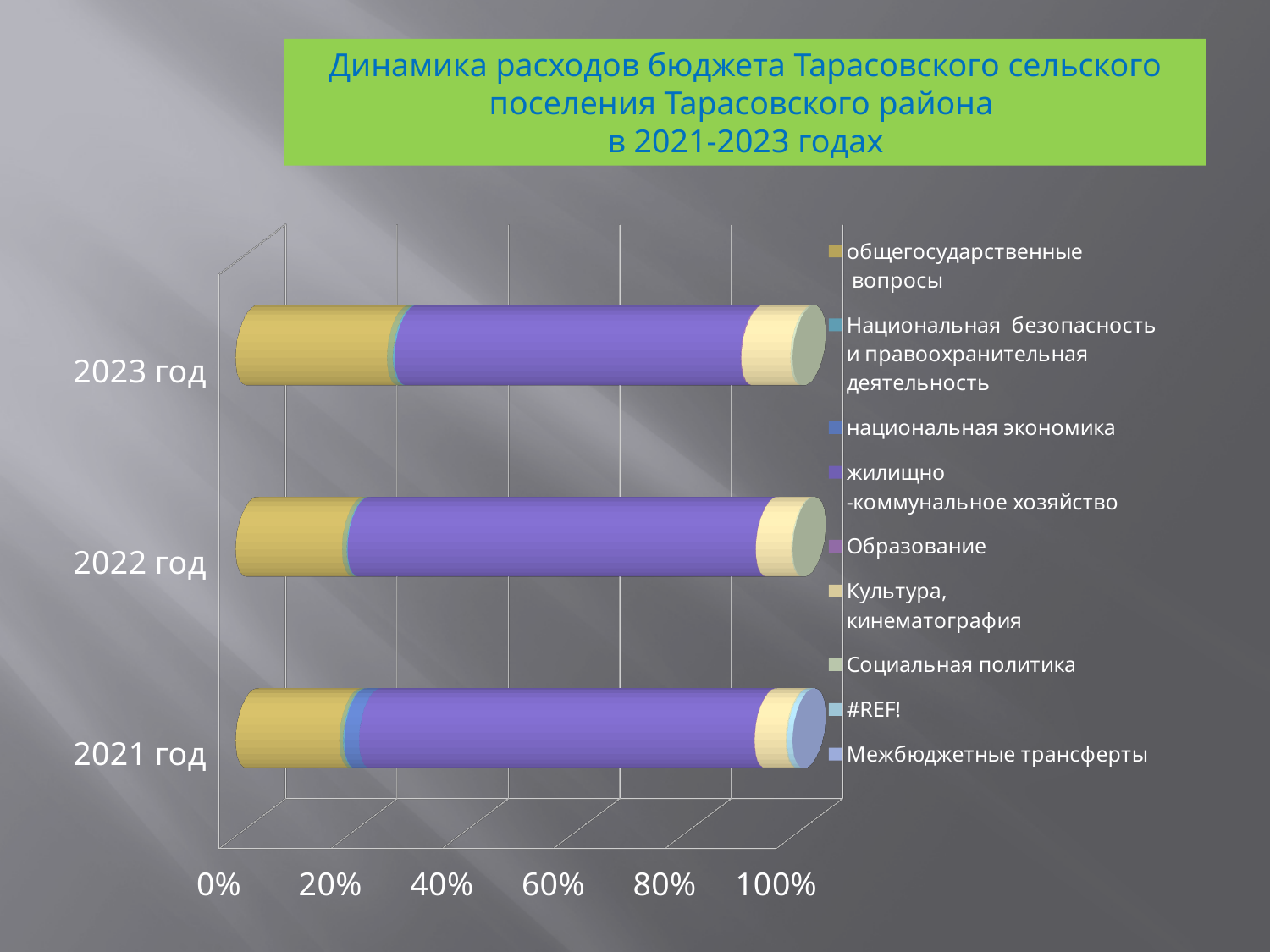
Is the share of жилищно-коммунальное хозяйство in 2023 год greater or less than 40%? greater What is the highest value shown on the horizontal axis? 100% Is the share of Культура, кинематография in 2022 год greater or less than 20%? less Which legend entry appears as an error reference rather than a category name? #REF! Is the share of жилищно-коммунальное хозяйство in 2021 год greater or less than 60%? greater How many series does the legend list? 9 How many years (categories) are plotted on the chart? 3 What kind of chart is shown on the slide? Stacked bar chart In the 2023 год bar, which segment is larger: общегосударственные вопросы or жилищно-коммунальное хозяйство? жилищно-коммунальное хозяйство Which series forms the largest segment of the 2022 год bar? жилищно-коммунальное хозяйство In which year is the общегосударственные вопросы segment the largest? 2023 год